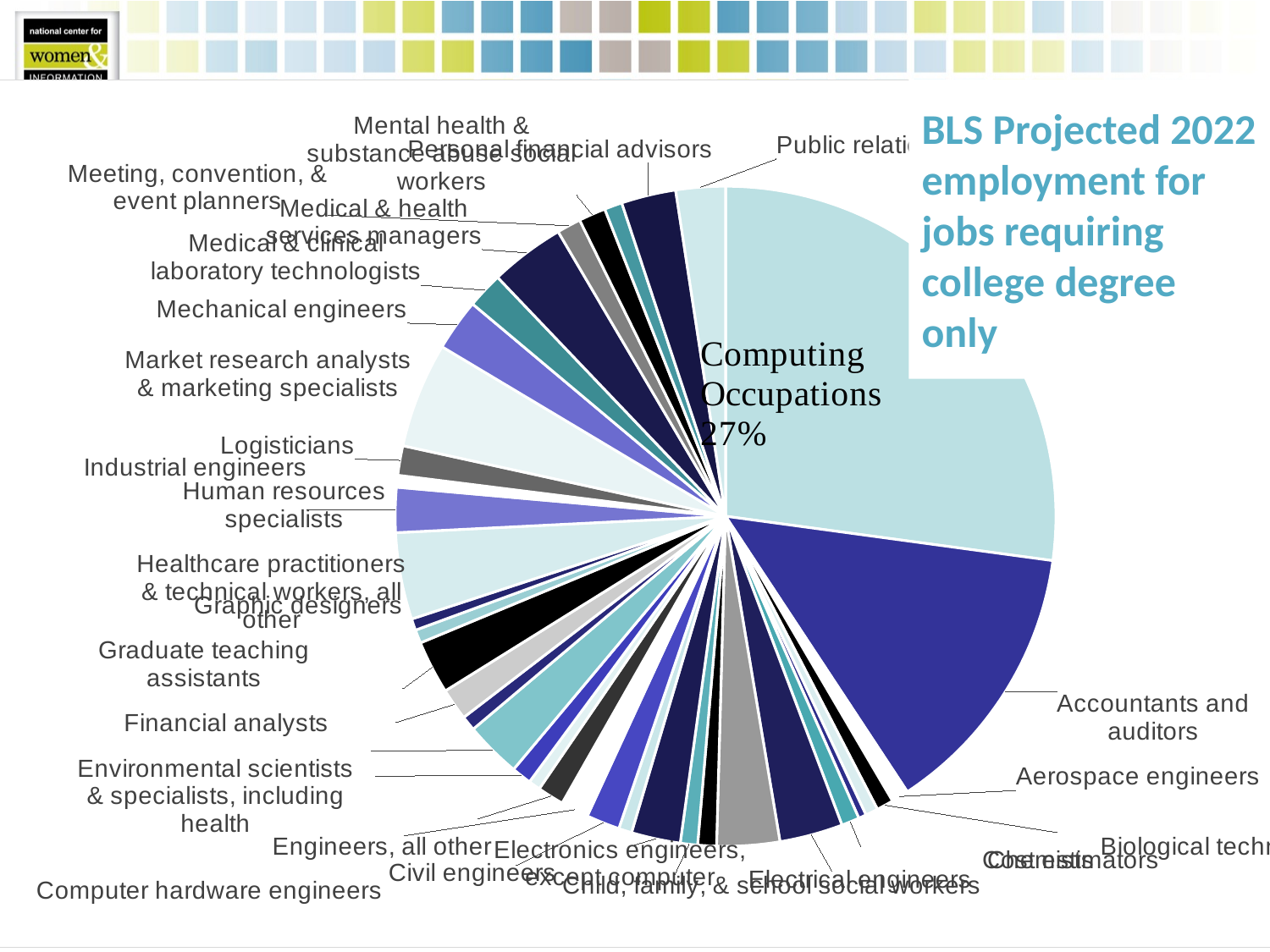
Which slice is larger, Accountants and auditors or Mechanical engineers? Accountants and auditors Which slice is the only one labeled with a percentage value? Computing Occupations Which category has the largest slice of the pie? Computing Occupations Is the share for Computing Occupations greater or less than 50%? less What share of the pie is labeled for Computing Occupations? 27% What kind of chart is shown on the slide? pie chart Which slice is larger, Computing Occupations or Accountants and auditors? Computing Occupations What is the title of the chart? BLS Projected 2022 employment for jobs requiring college degree only Which slice is larger, Accountants and auditors or Aerospace engineers? Accountants and auditors